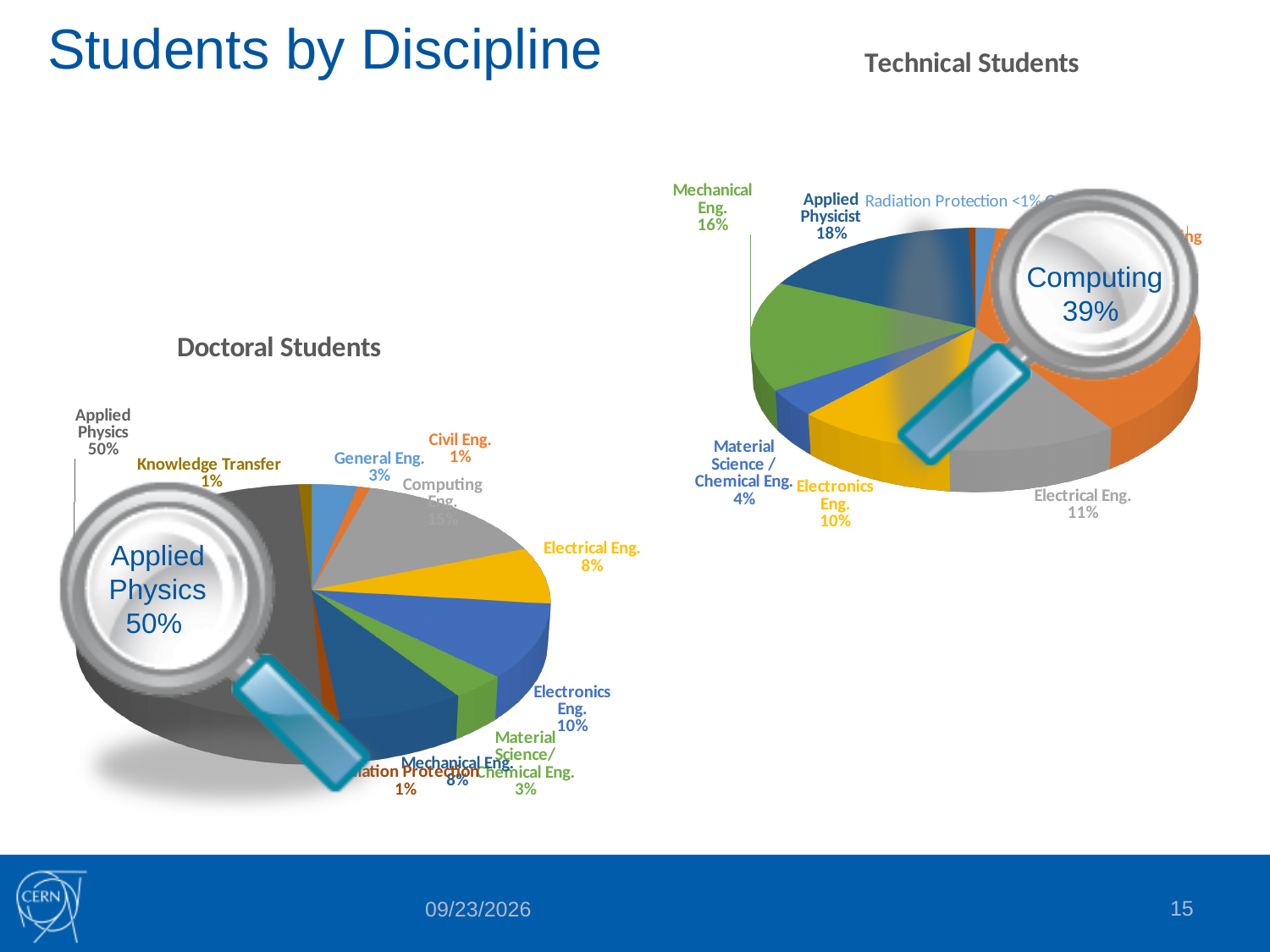
What kind of chart is used for the Technical Students data? Pie chart In the Technical Students chart, what percentage is shown for Mechanical Eng.? 16% In the Technical Students chart, what percentage is shown for Applied Physicist? 18% In the Technical Students chart, which is larger, Electrical Eng. or Material Science / Chemical Eng.? Electrical Eng. In the Doctoral Students chart, what percentage is shown for Electronics Eng.? 10% In the Technical Students chart, what share of students is in Computing? 39% In the Doctoral Students chart, what is the difference between the Applied Physics share and the Electronics Eng. share? 40% In the Doctoral Students chart, what percentage is shown for Electrical Eng.? 8% In the Doctoral Students chart, what share of students is in Applied Physics? 50% In the Doctoral Students chart, what percentage is shown for General Eng.? 3% In the Doctoral Students chart, which discipline has the largest share? Applied Physics In the Doctoral Students chart, which is larger, Electronics Eng. or Electrical Eng.? Electronics Eng.